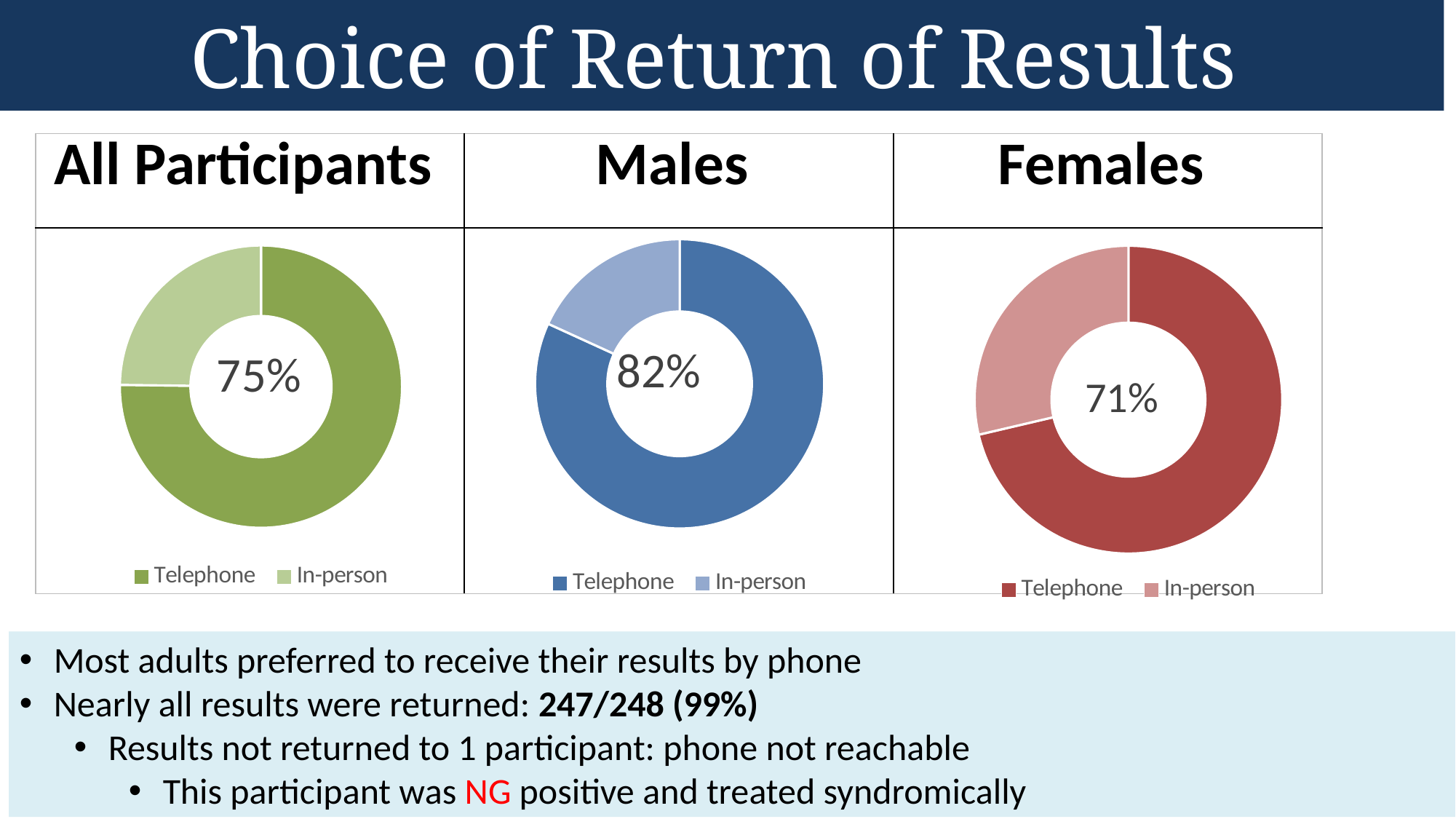
Which of the three charts shows the highest percentage in its centre? Males What are the two legend entries in the Females chart? Telephone and In-person What percentage is shown in the centre of the All Participants donut chart? 75% In the Females chart, which option has the smaller share: Telephone or In-person? In-person What percentage is shown in the centre of the Males donut chart? 82% Which of the three charts shows the lowest percentage in its centre? Females In the Males chart, which option has the larger share: Telephone or In-person? Telephone How many categories does the legend of the All Participants chart list? 2 What is the difference between the percentage shown in the Males chart and the percentage shown in the All Participants chart? 7% What percentage is shown in the centre of the Females donut chart? 71% What type of chart is used for All Participants, Males and Females? Donut (pie) chart What is the difference between the percentage shown in the Males chart and the percentage shown in the Females chart? 11%